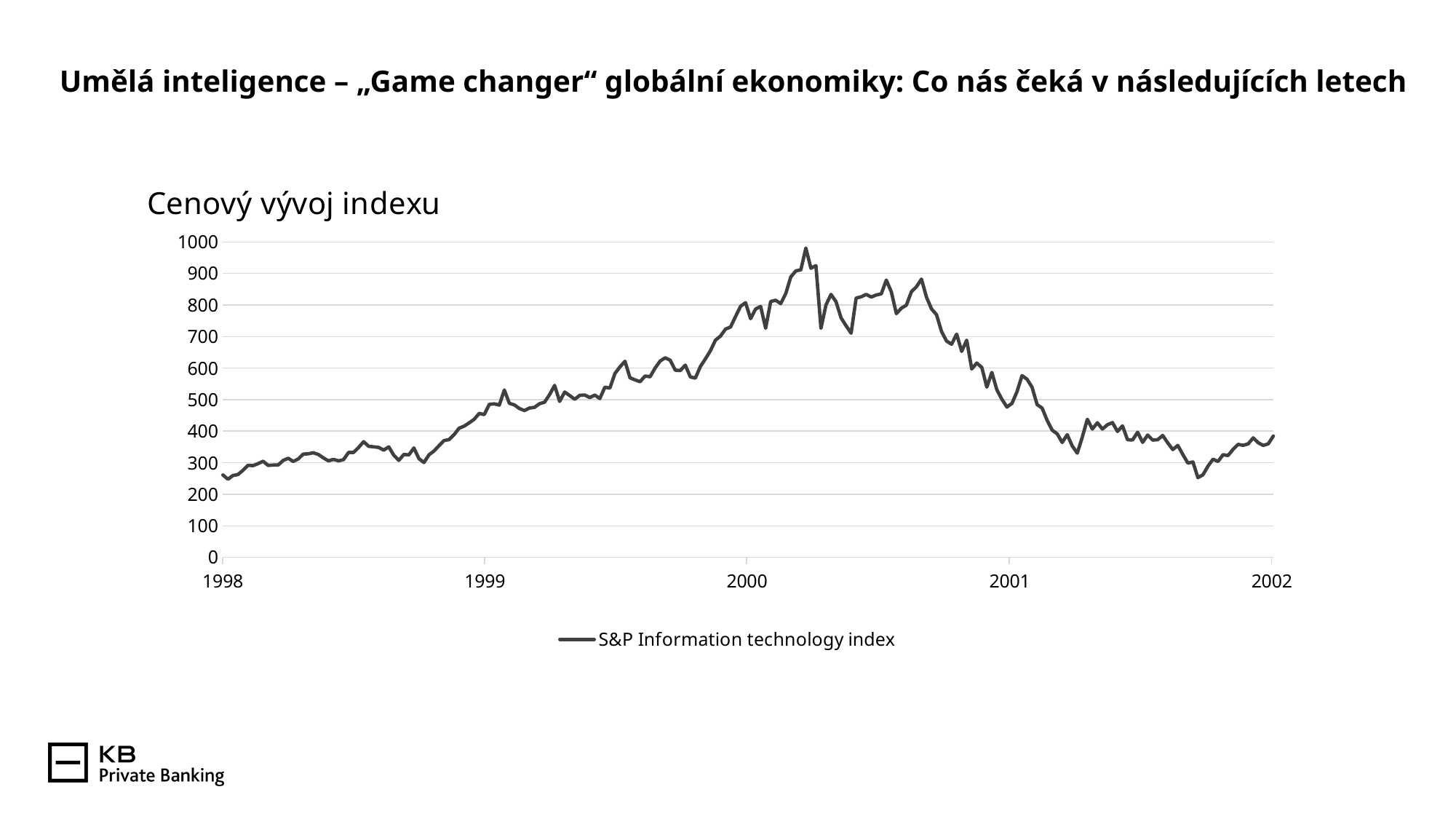
In which year on the x axis does the index reach its peak? 2000 Does the index rise or fall overall between 2000 and 2002? Fall Is the highest value reached by the index greater or less than 900? greater Does the index rise or fall between 1998 and 2000? Rise Is the value of the index at the 1999 tick greater or less than 400? greater What is the highest value shown on the y axis? 1000 Is the value of the index at the start of 1998 greater or less than 300? less How many series does the legend list? 1 What is the title of the chart? Cenový vývoj indexu What kind of chart is shown on the slide? Line chart What is the name of the series shown in the legend? S&P Information technology index